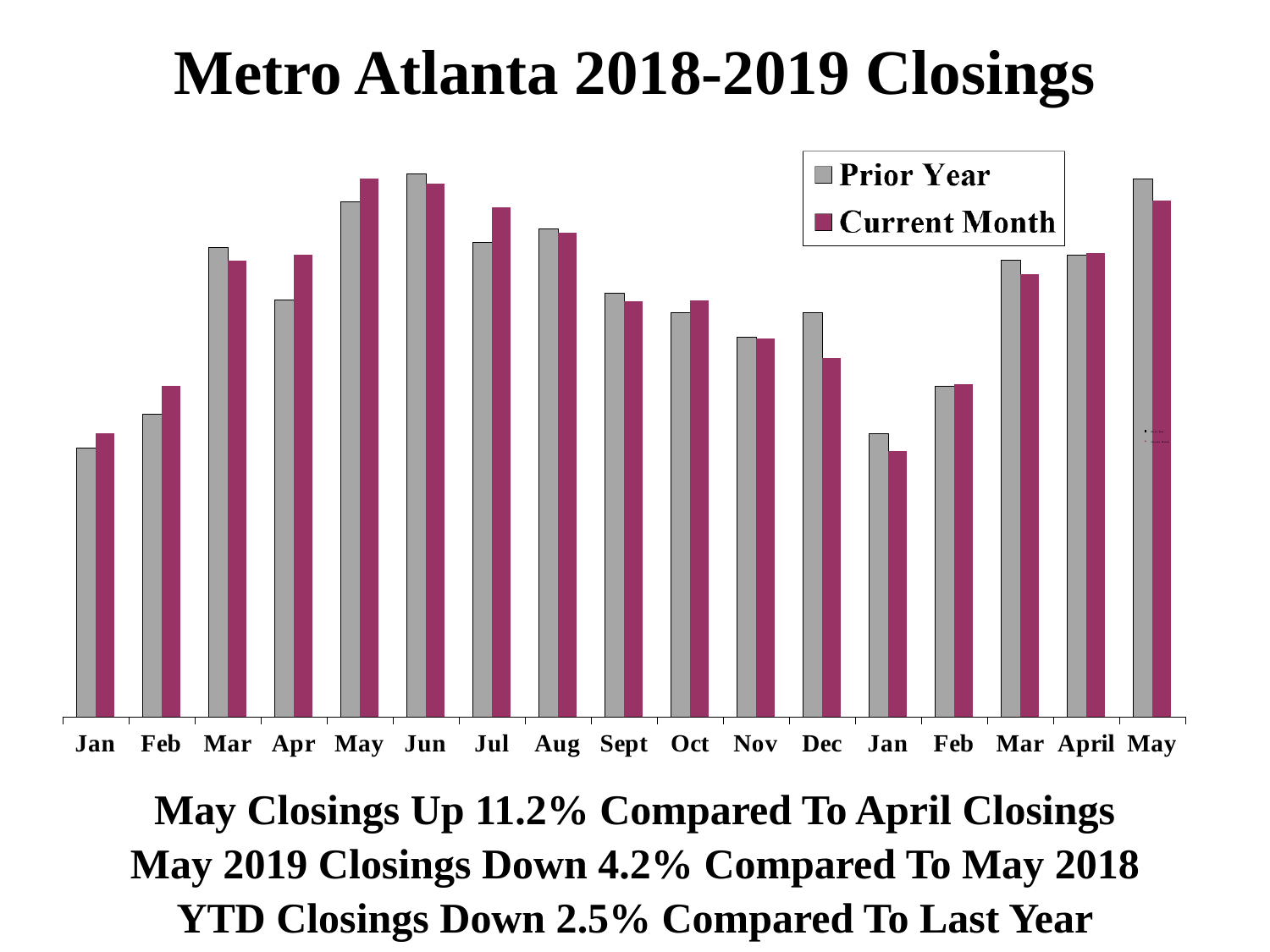
How many series does the legend list? 2 What kind of chart is shown on the slide? Bar chart How many month categories are shown along the x axis? 17 For the Prior Year series, is the bar for Jun taller or shorter than the bar for Dec? Taller Do the Prior Year bars generally rise or fall from Jun through Dec? Fall Do the Current Month bars generally rise or fall from the leftmost Jan through May? Rise In Jul, which series has the taller bar, Prior Year or Current Month? Current Month In Dec, which series has the taller bar, Prior Year or Current Month? Prior Year What is the title of the chart? Metro Atlanta 2018-2019 Closings Which series is shown in gray according to the legend? Prior Year